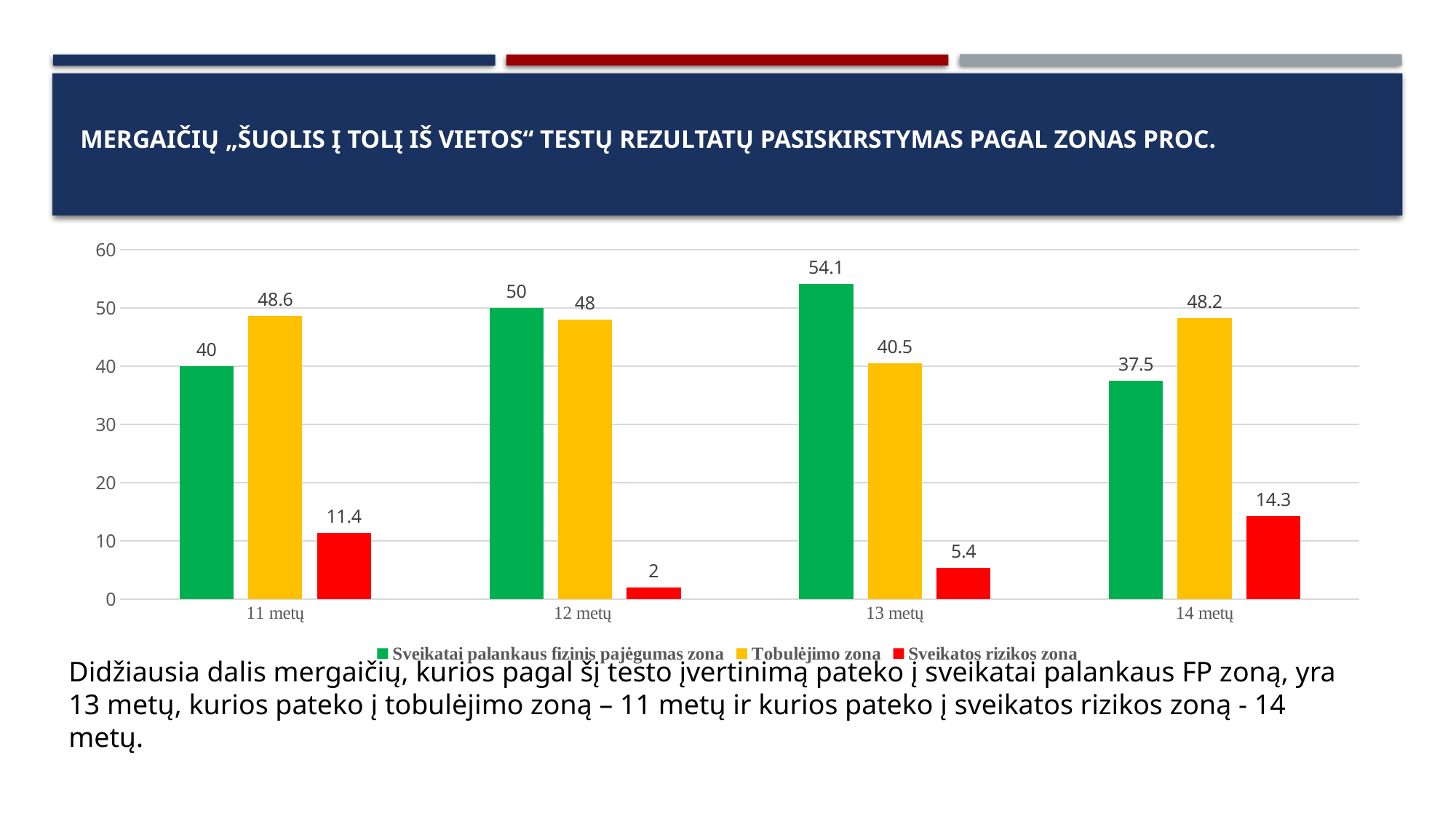
How many age groups are shown on the x axis? 4 What is the value for "Sveikatai palankaus fizinis pajėgumas zona" at 13 metų? 54.1 Which age group has the lowest value for "Sveikatos rizikos zona"? 12 metų Which age group has the highest value for "Sveikatai palankaus fizinis pajėgumas zona"? 13 metų What is the value for "Tobulėjimo zona" at 11 metų? 48.6 What is the value for "Sveikatos rizikos zona" at 14 metų? 14.3 What is the value for "Sveikatos rizikos zona" at 12 metų? 2 What colour represents "Sveikatos rizikos zona" in the chart? Red What is the difference between the "Tobulėjimo zona" value at 11 metų and at 13 metų? 8.1 Which is larger at 14 metų: "Sveikatai palankaus fizinis pajėgumas zona" or "Tobulėjimo zona"? Tobulėjimo zona What kind of chart is shown on the slide? Bar chart How many series does the legend list? 3